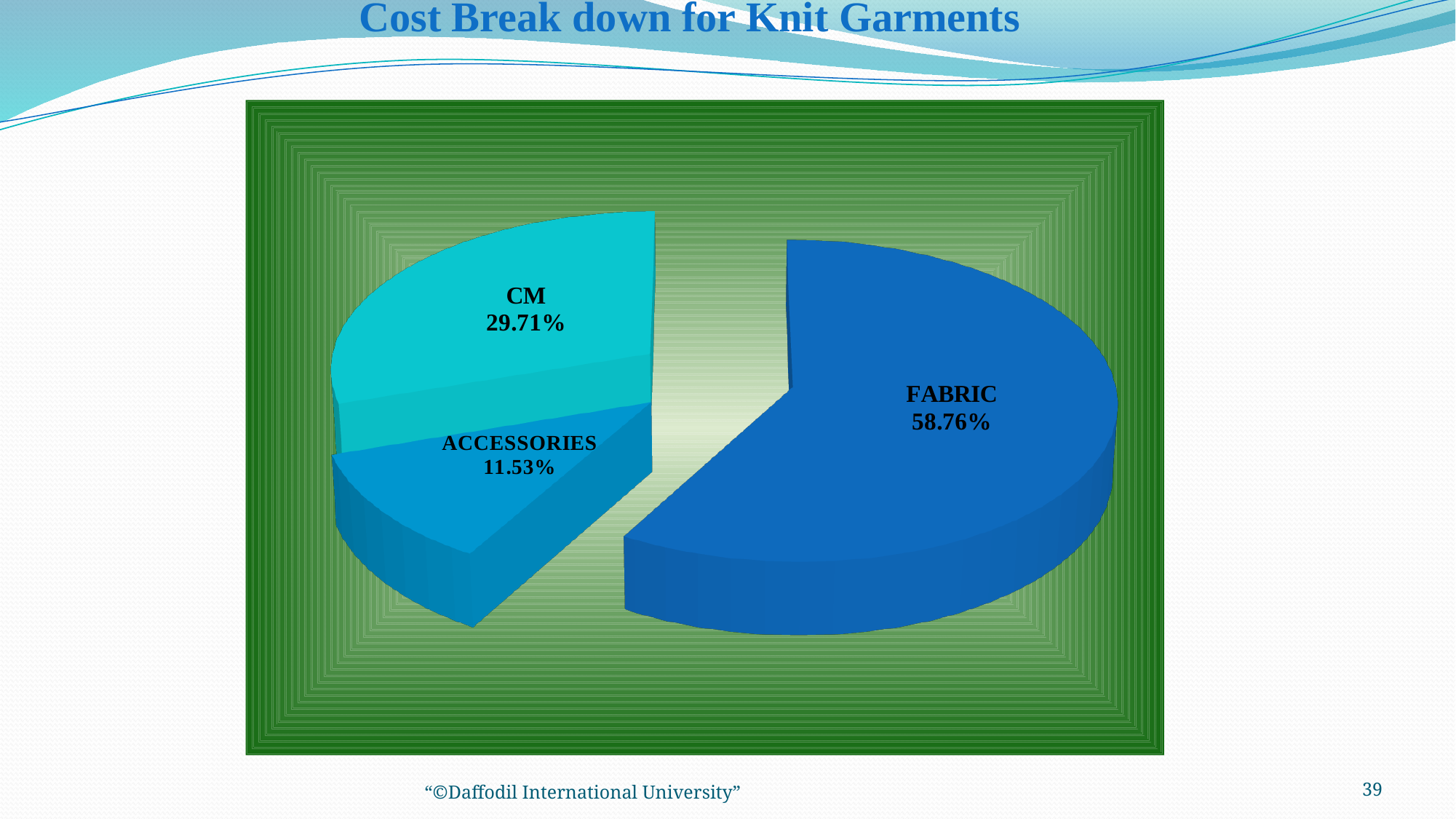
Which category has the largest share of the cost? FABRIC How many slices does the pie chart have? 3 What kind of chart is shown on the slide? Pie chart What is the title of the slide? Cost Break down for Knit Garments Which is larger, the share for CM or the share for ACCESSORIES? CM What share of the cost does FABRIC account for? 58.76% What is the difference between the FABRIC share and the CM share? 29.05% What share of the cost does ACCESSORIES account for? 11.53% What is the difference between the CM share and the ACCESSORIES share? 18.18% Which category has the smallest share of the cost? ACCESSORIES What share of the cost does CM account for? 29.71% What is the combined share of CM and ACCESSORIES? 41.24%